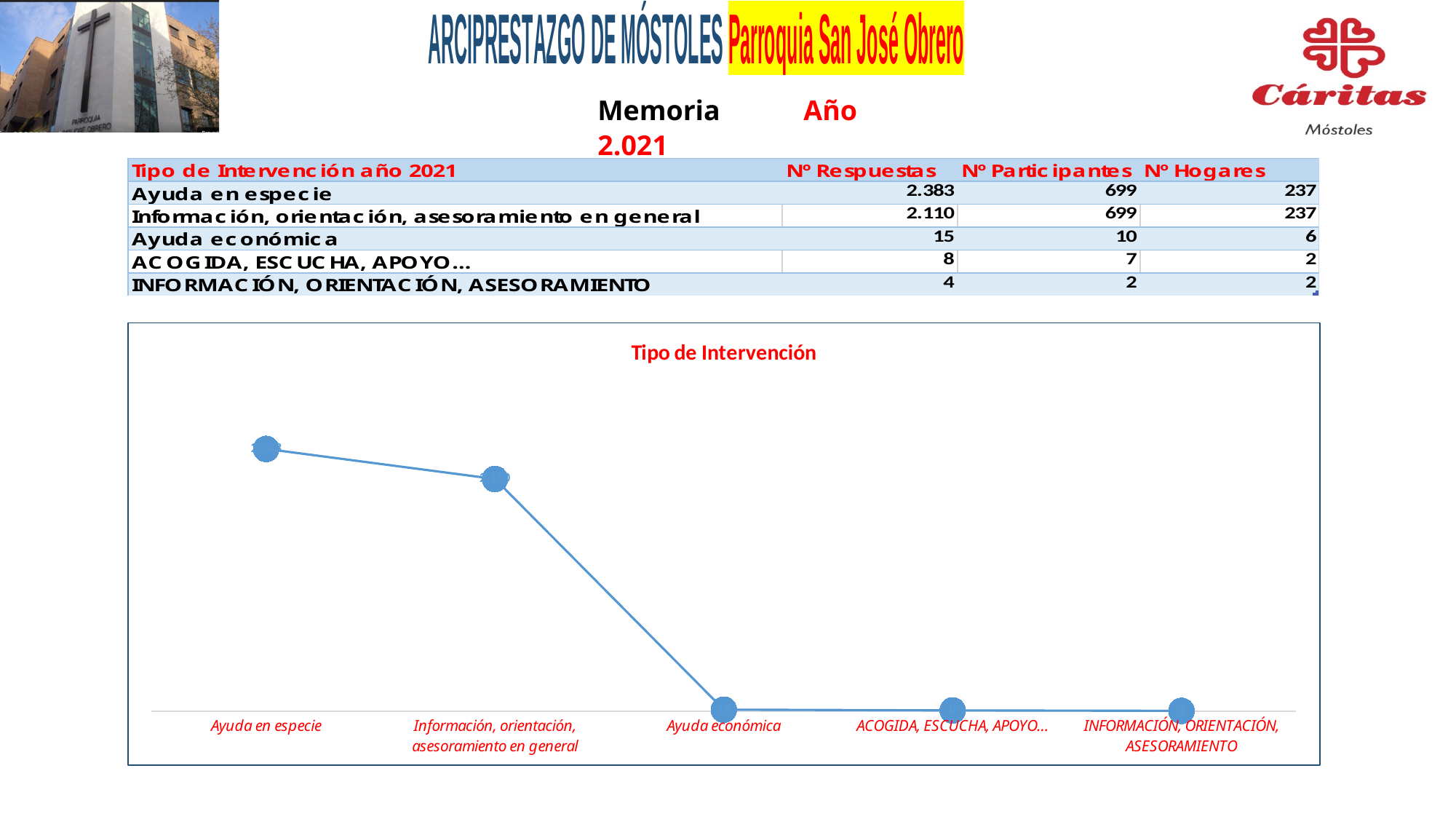
How many categories are plotted along the x axis of the chart? 5 Which is higher in the chart, Ayuda en especie or Información, orientación, asesoramiento en general? Ayuda en especie What kind of chart is shown under the title "Tipo de Intervención"? line chart Do the values in the chart rise or fall from left to right along the x axis? fall How many lines (series) are plotted in the chart? 1 Which category has the highest point in the chart? Ayuda en especie What is the title of the chart? Tipo de Intervención Which is higher in the chart, Ayuda en especie or ACOGIDA, ESCUCHA, APOYO…? Ayuda en especie What is the first category on the x axis of the chart? Ayuda en especie Which is higher in the chart, Información, orientación, asesoramiento en general or Ayuda económica? Información, orientación, asesoramiento en general